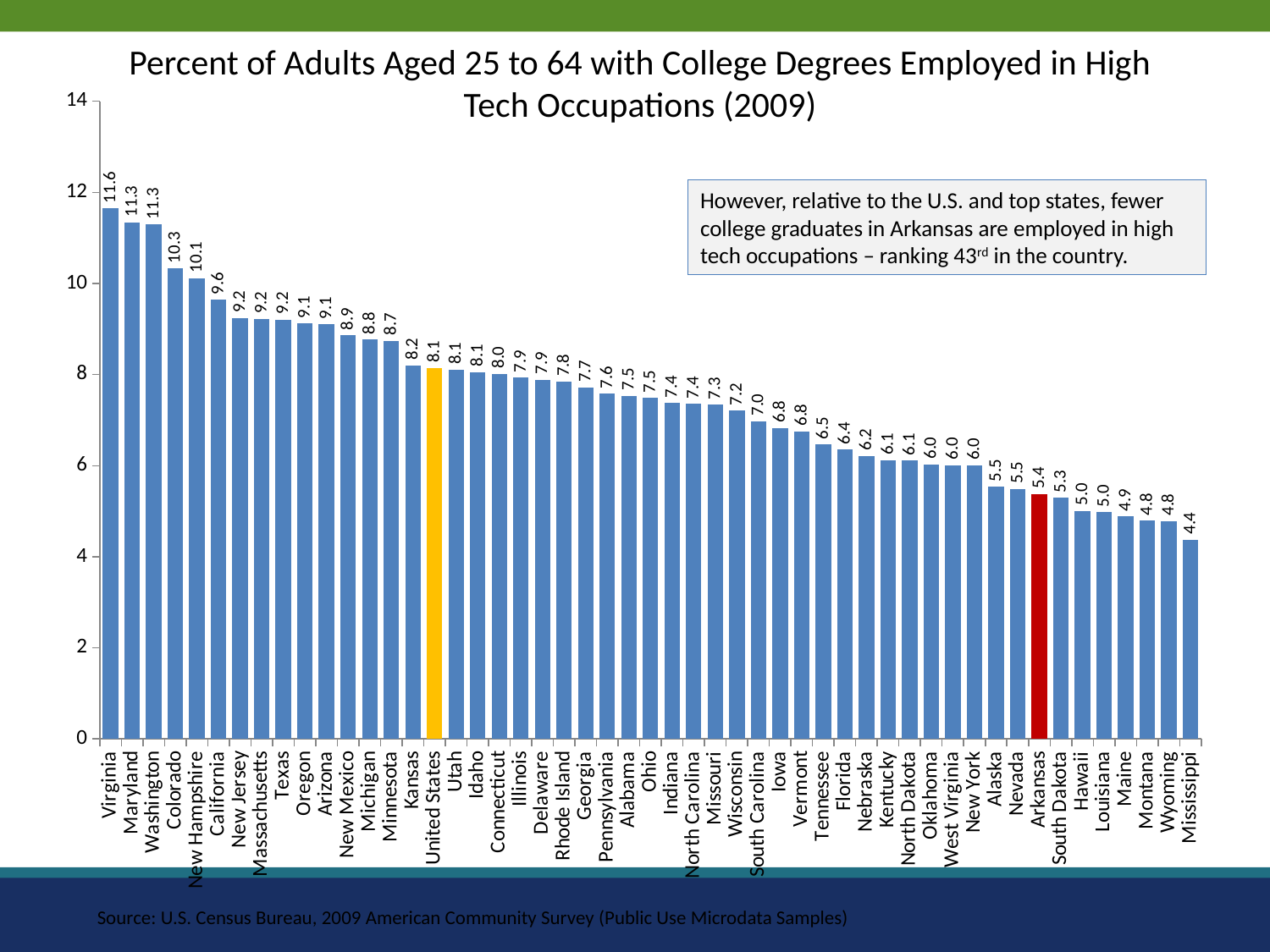
What is the difference between the United States value and the Arkansas value? 2.7 Which has a larger value, Colorado or Texas? Colorado Which bar is highlighted in red on the chart? Arkansas Do the values rise or fall moving from left to right along the x axis? Fall Which state has the lowest value on the chart? Mississippi What is the difference between the values for Virginia and Arkansas? 6.2 What is the value shown for Arkansas? 5.4 What is the value shown for Virginia? 11.6 Is the value for Maryland greater or less than 10? greater Which state has the highest value on the chart? Virginia What kind of chart is shown on the slide? Bar chart What is the value shown for the United States bar? 8.1